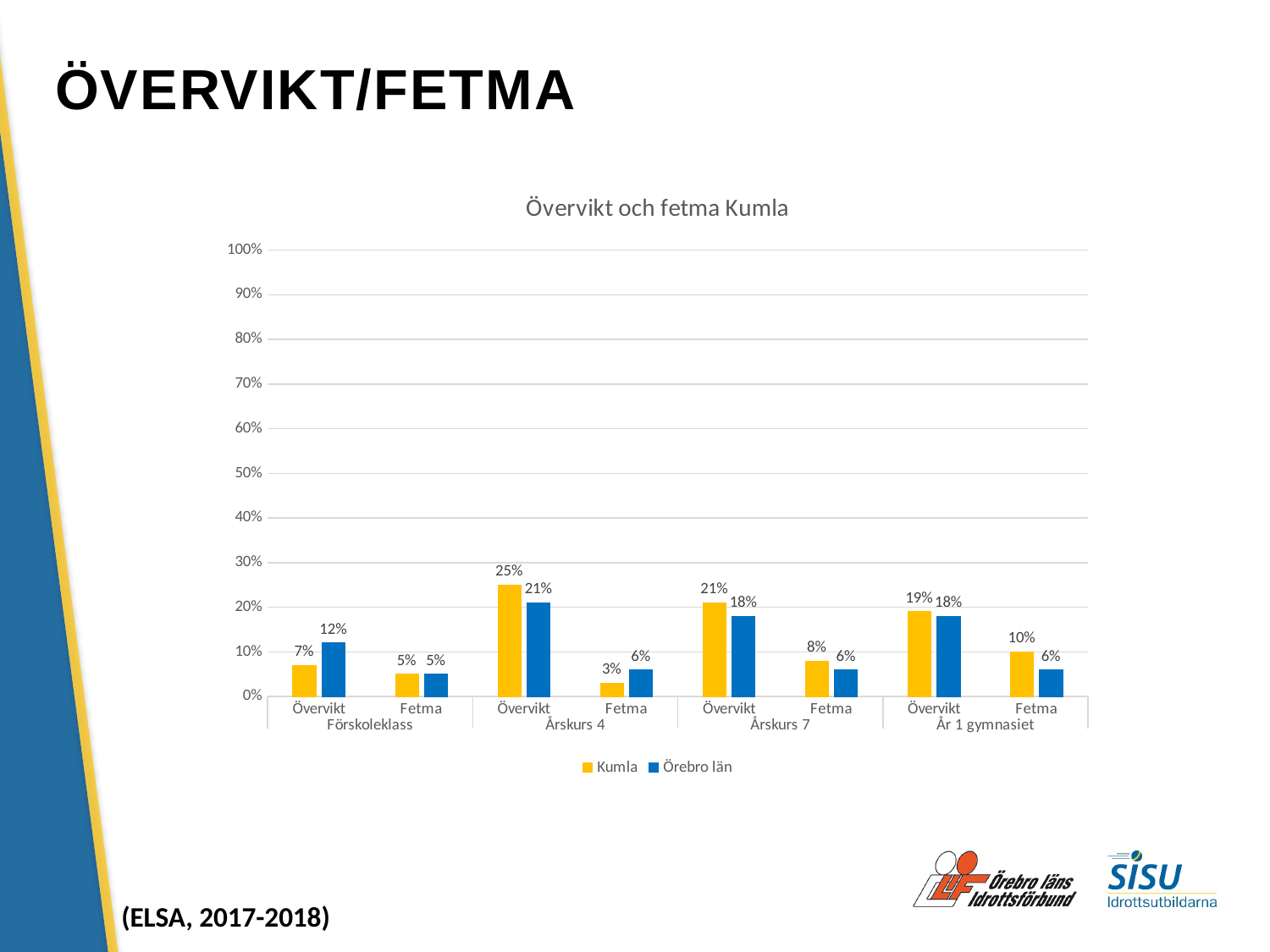
What is the title of the chart? Övervikt och fetma Kumla What is the Örebro län value for Övervikt in År 1 gymnasiet? 18% What kind of chart is shown? Bar chart How many series does the legend list? 2 What is the Kumla value for Övervikt in Årskurs 7? 21% Which category has the lowest Kumla value? Fetma, Årskurs 4 Which category has the highest Kumla value? Övervikt, Årskurs 4 What is the Örebro län value for Fetma in Årskurs 4? 6% What is the difference between the Kumla and Örebro län values for Övervikt in Förskoleklass? 5% Which is larger for Fetma in År 1 gymnasiet: Kumla or Örebro län? Kumla What is the Kumla value for Övervikt in Förskoleklass? 7% Is the Kumla value for Övervikt in Årskurs 4 greater or less than 20%? greater